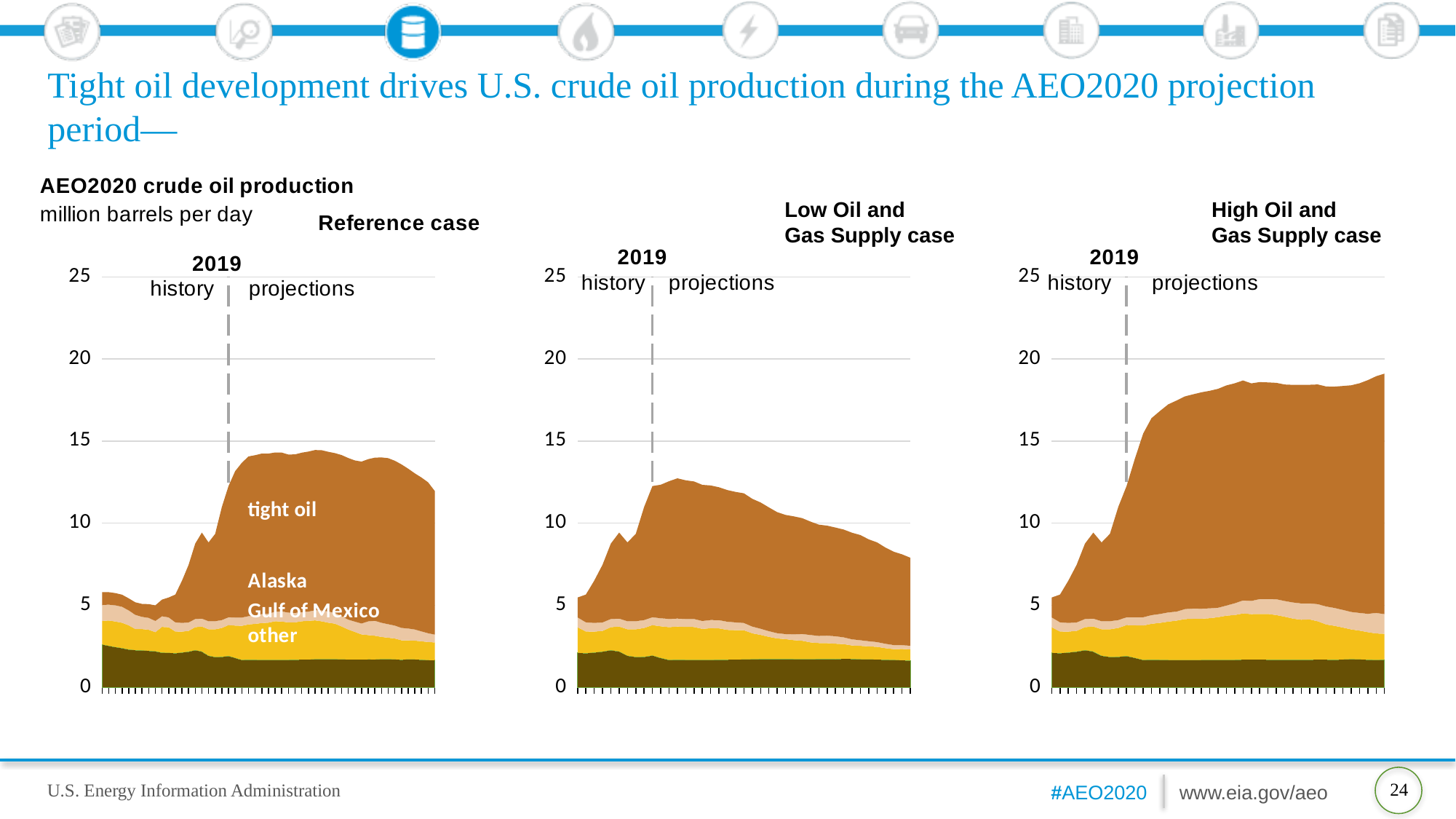
In the Low Oil and Gas Supply case chart, is the total crude oil production at the end of the projection period greater or less than 10? less In the High Oil and Gas Supply case chart, is the peak total crude oil production greater or less than 20? less What kind of chart is used for the Reference case? stacked area chart At the end of the projection period, is total crude oil production larger in the Reference case or the Low Oil and Gas Supply case? Reference case In the Low Oil and Gas Supply case chart, does total crude oil production rise or fall over the projection period after its early peak? fall In the Reference case chart, which category forms the largest (top) area during the projection period? tight oil How many production categories are labeled in the Reference case chart? 4 In the High Oil and Gas Supply case chart, is the total crude oil production at the end of the projection period greater or less than 15? greater How many charts are shown on the slide? 3 Which case shows the highest total crude oil production at the end of the projection period? High Oil and Gas Supply case What unit is used on the y axis of the charts? million barrels per day